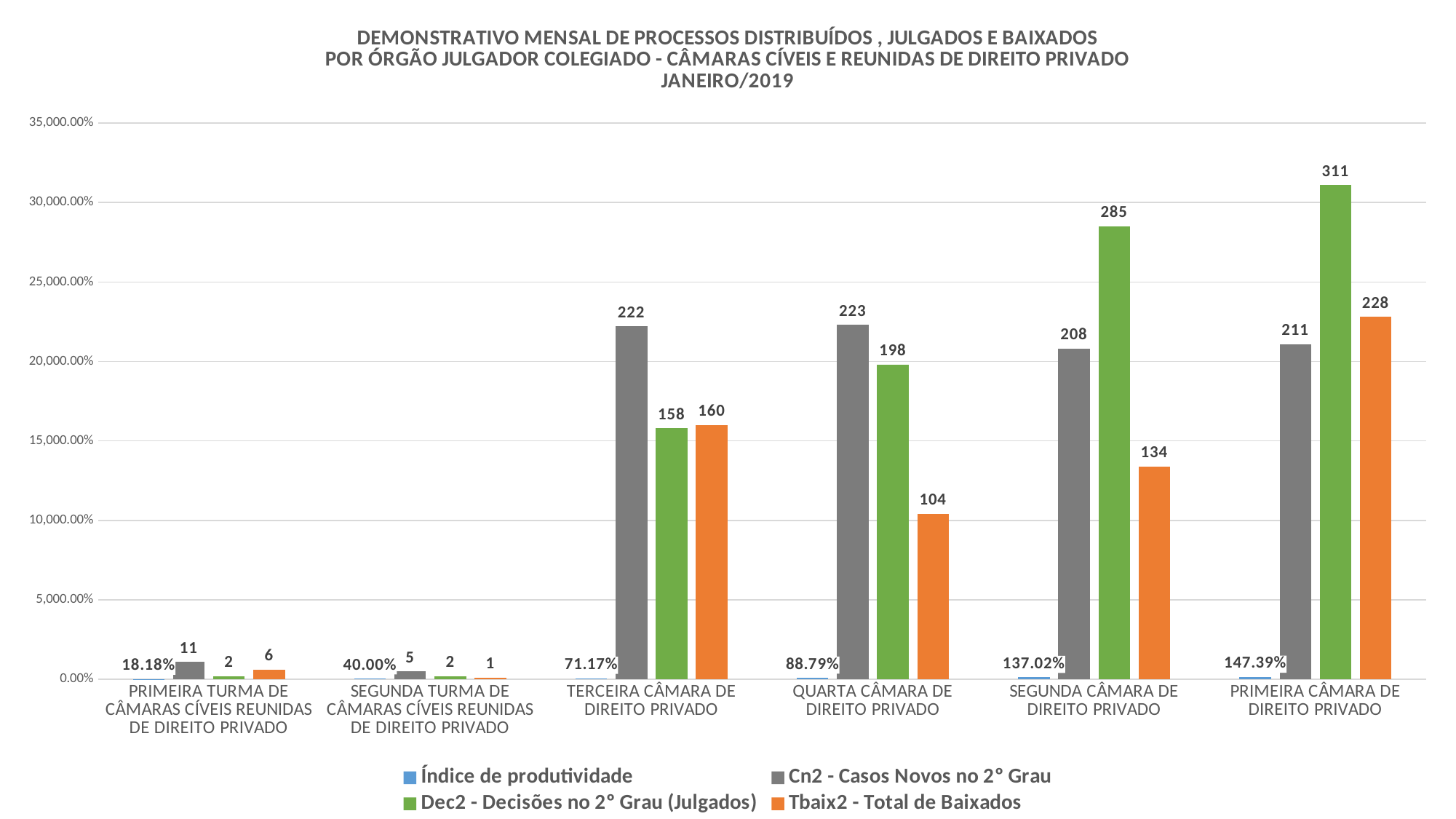
What is the difference between Dec2 - Decisões no 2° Grau (Julgados) and Cn2 - Casos Novos no 2° Grau for PRIMEIRA CÂMARA DE DIREITO PRIVADO? 100 How many categories (órgãos julgadores) are shown on the x axis? 6 What type of chart is shown on the slide? bar chart What is the value of Cn2 - Casos Novos no 2° Grau for TERCEIRA CÂMARA DE DIREITO PRIVADO? 222 How many series does the legend list? 4 Which category has the lowest value for Tbaix2 - Total de Baixados? SEGUNDA TURMA DE CÂMARAS CÍVEIS REUNIDAS DE DIREITO PRIVADO Which category has the highest value for Dec2 - Decisões no 2° Grau (Julgados)? PRIMEIRA CÂMARA DE DIREITO PRIVADO What is the Índice de produtividade for PRIMEIRA TURMA DE CÂMARAS CÍVEIS REUNIDAS DE DIREITO PRIVADO? 18.18% Does the Índice de produtividade rise or fall from left to right across the categories? rise What is the Índice de produtividade for SEGUNDA CÂMARA DE DIREITO PRIVADO? 137.02% What is the value of Tbaix2 - Total de Baixados for QUARTA CÂMARA DE DIREITO PRIVADO? 104 Which is larger for SEGUNDA CÂMARA DE DIREITO PRIVADO: Cn2 - Casos Novos no 2° Grau or Dec2 - Decisões no 2° Grau (Julgados)? Dec2 - Decisões no 2° Grau (Julgados)